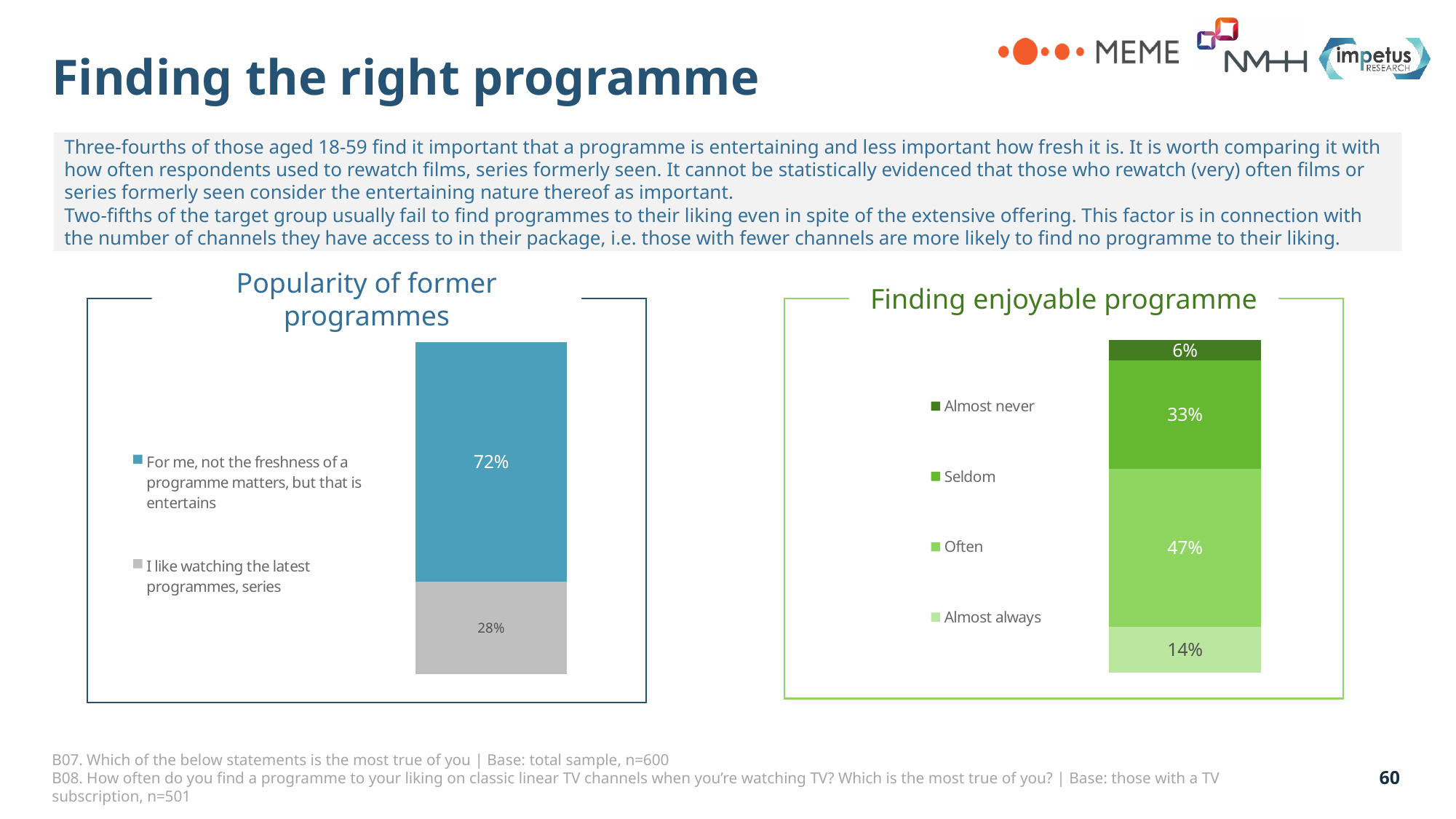
In the 'Finding enjoyable programme' chart, what is the total of the stacked bar? 100% In the 'Popularity of former programmes' chart, what percentage is shown for 'I like watching the latest programmes, series'? 28% In the 'Finding enjoyable programme' chart, which category has the smallest share? Almost never In the 'Popularity of former programmes' chart, what percentage is shown for 'For me, not the freshness of a programme matters, but that is entertains'? 72% In the 'Popularity of former programmes' chart, what is the difference between the two segments? 44 percentage points In the 'Finding enjoyable programme' chart, what percentage is shown for 'Seldom'? 33% In the 'Finding enjoyable programme' chart, what percentage is shown for 'Almost always'? 14% In the 'Finding enjoyable programme' chart, which category has the largest share? Often In the 'Finding enjoyable programme' chart, which is larger: 'Seldom' or 'Almost always'? Seldom In the 'Popularity of former programmes' chart, how many series does the legend list? 2 In the 'Finding enjoyable programme' chart, what percentage is shown for 'Almost never'? 6% What type of chart is the 'Finding enjoyable programme' chart? Stacked bar chart